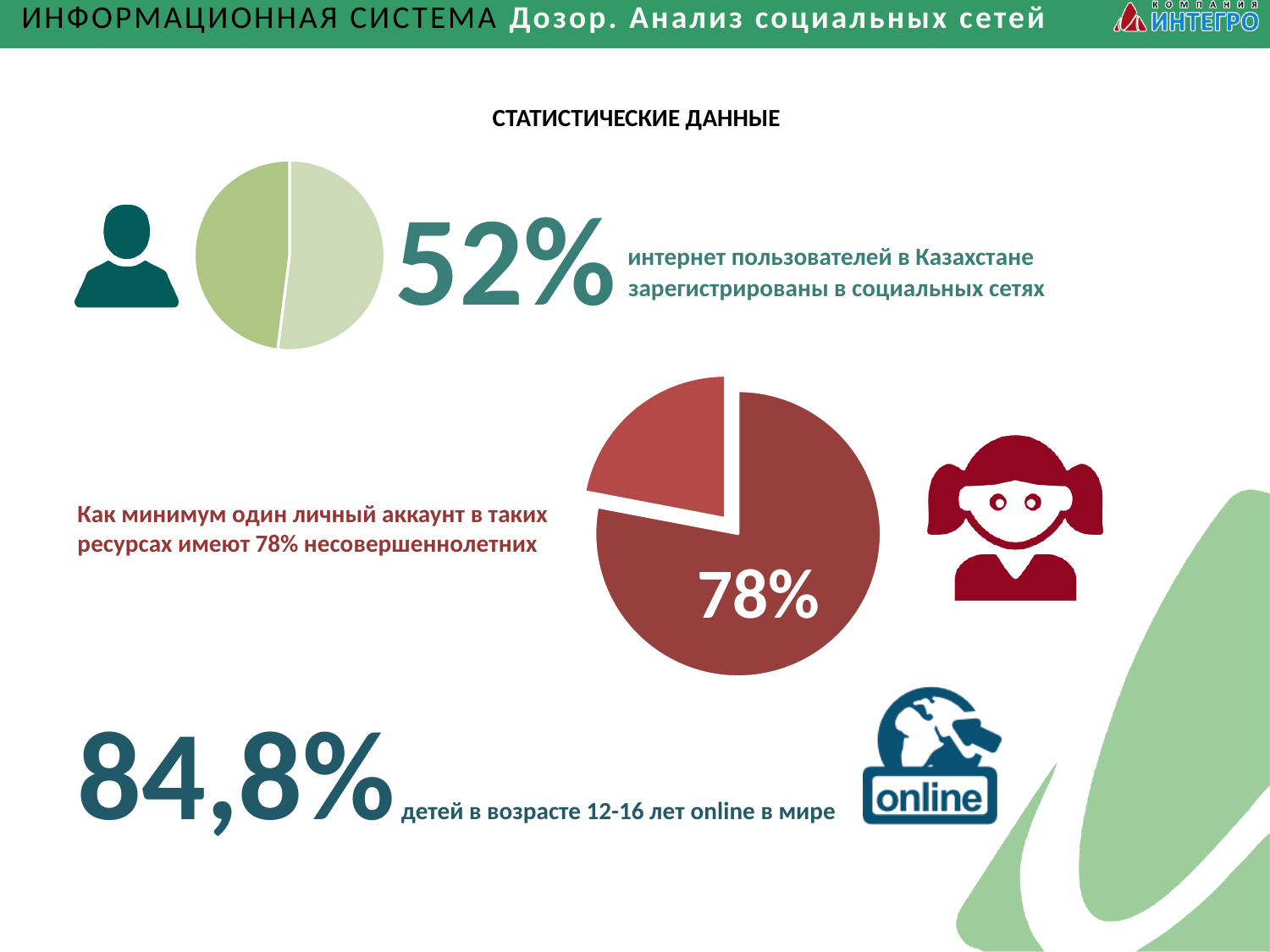
In the red pie chart, what value is printed on the large slice? 78% How many slices does the green pie chart at the top have? 2 In the red pie chart, which slice is larger, the dark red slice or the lighter exploded slice? the dark red slice In the red pie chart, is the smaller slice pulled out (exploded) from the rest of the pie? yes How many slices does the red pie chart have? 2 What kind of chart is the green chart at the top of the slide? pie chart In the red pie chart, what share of the pie does the large dark red slice represent? 78% What percentage is printed next to the green pie chart at the top of the slide? 52% What kind of chart is the red chart in the middle of the slide? pie chart What colour is the large slice of the pie chart in the middle of the slide? dark red How many pie charts are shown on the slide? 2